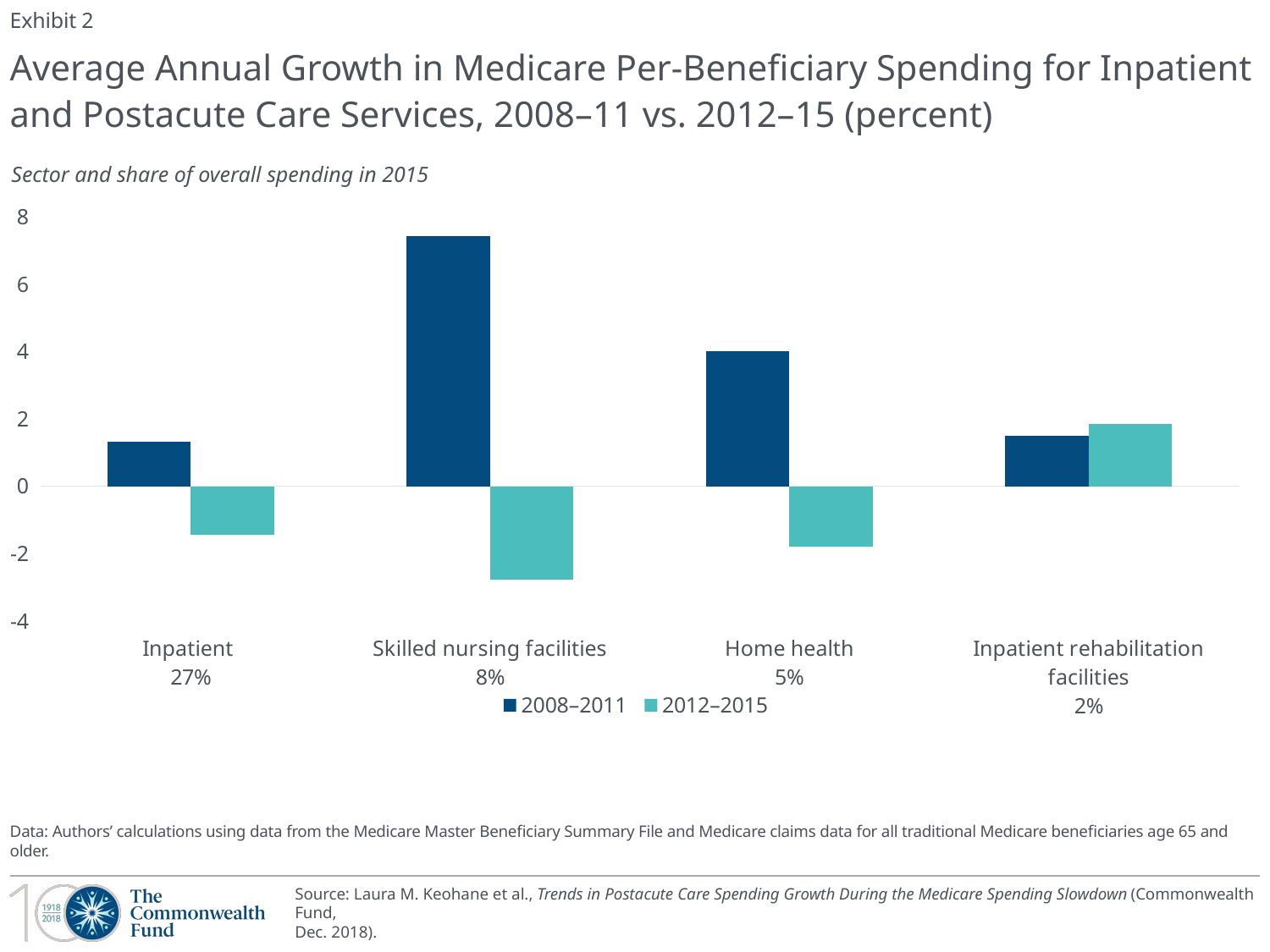
Is the 2012–2015 value for Skilled nursing facilities greater or less than -2? less Is the 2008–2011 value for Skilled nursing facilities greater or less than 6? greater How many sectors (categories) are shown on the x axis? 4 How many series does the legend list? 2 Is the 2008–2011 value for Home health greater or less than 2? greater For 2008–2011, which is larger: Skilled nursing facilities or Home health? Skilled nursing facilities Which sector has the highest average annual growth for 2012–2015? Inpatient rehabilitation facilities Which sector has the lowest (most negative) average annual growth for 2012–2015? Skilled nursing facilities Which sector is the only one with positive growth in 2012–2015? Inpatient rehabilitation facilities What kind of chart is shown on the slide? bar chart What share of overall spending in 2015 is shown for Inpatient? 27% Which sector has the highest average annual growth for 2008–2011? Skilled nursing facilities